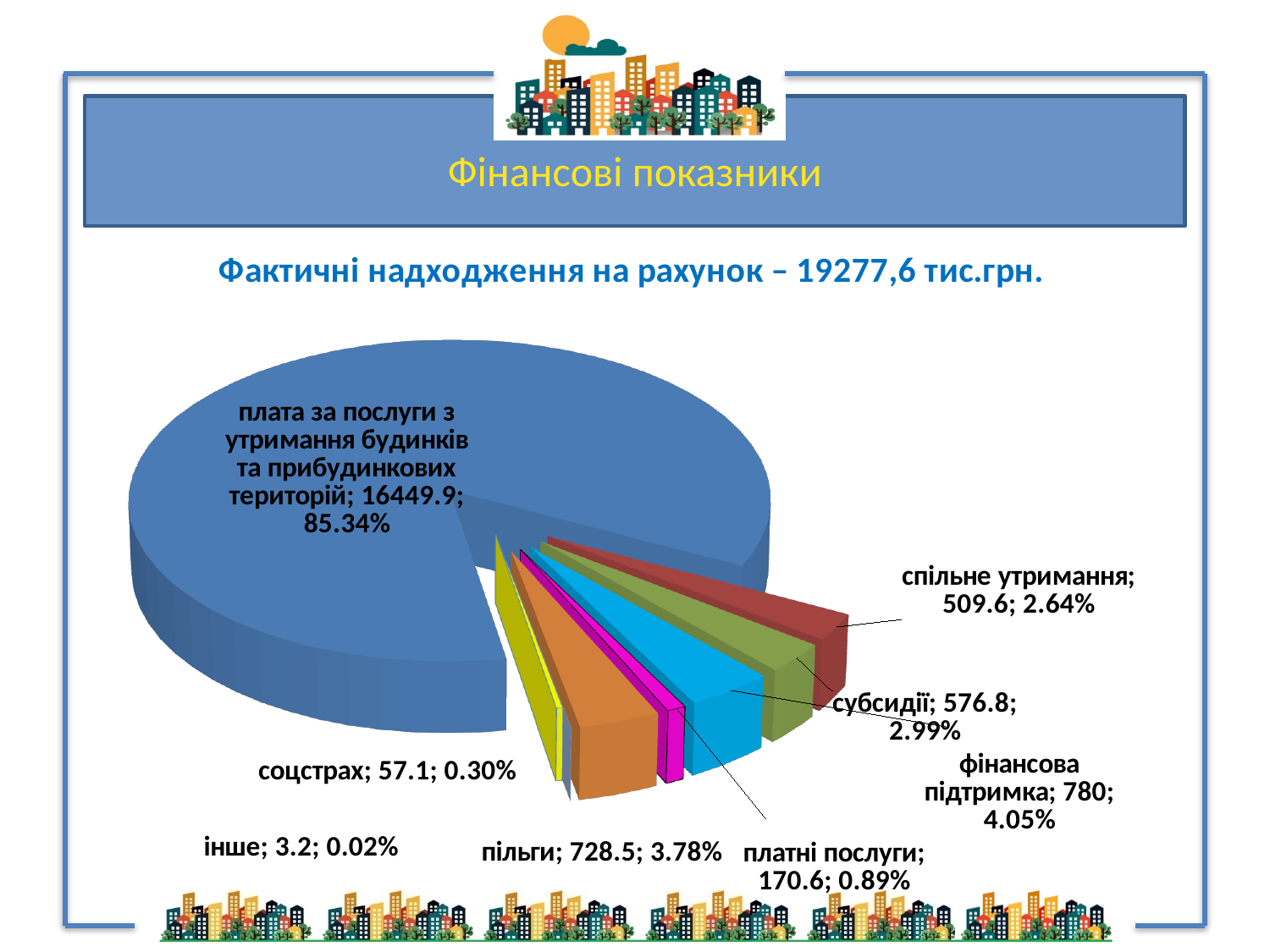
What is the difference between the values for "фінансова підтримка" and "пільги"? 51.5 What value is shown for "фінансова підтримка"? 780 What share of the pie does "субсидії" represent? 2.99% What total amount of actual receipts is stated in the heading above the chart? 19277,6 тис.грн. How many slices does the pie chart have? 8 What share of the pie does "соцстрах" represent? 0.30% What value is shown for "пільги"? 728.5 Which category has the largest slice of the pie? плата за послуги з утримання будинків та прибудинкових територій Which is larger, the value for "спільне утримання" or the value for "платні послуги"? спільне утримання What kind of chart is shown on the slide? pie chart Which category has the smallest slice of the pie? інше What share of the pie does "плата за послуги з утримання будинків та прибудинкових територій" represent? 85.34%